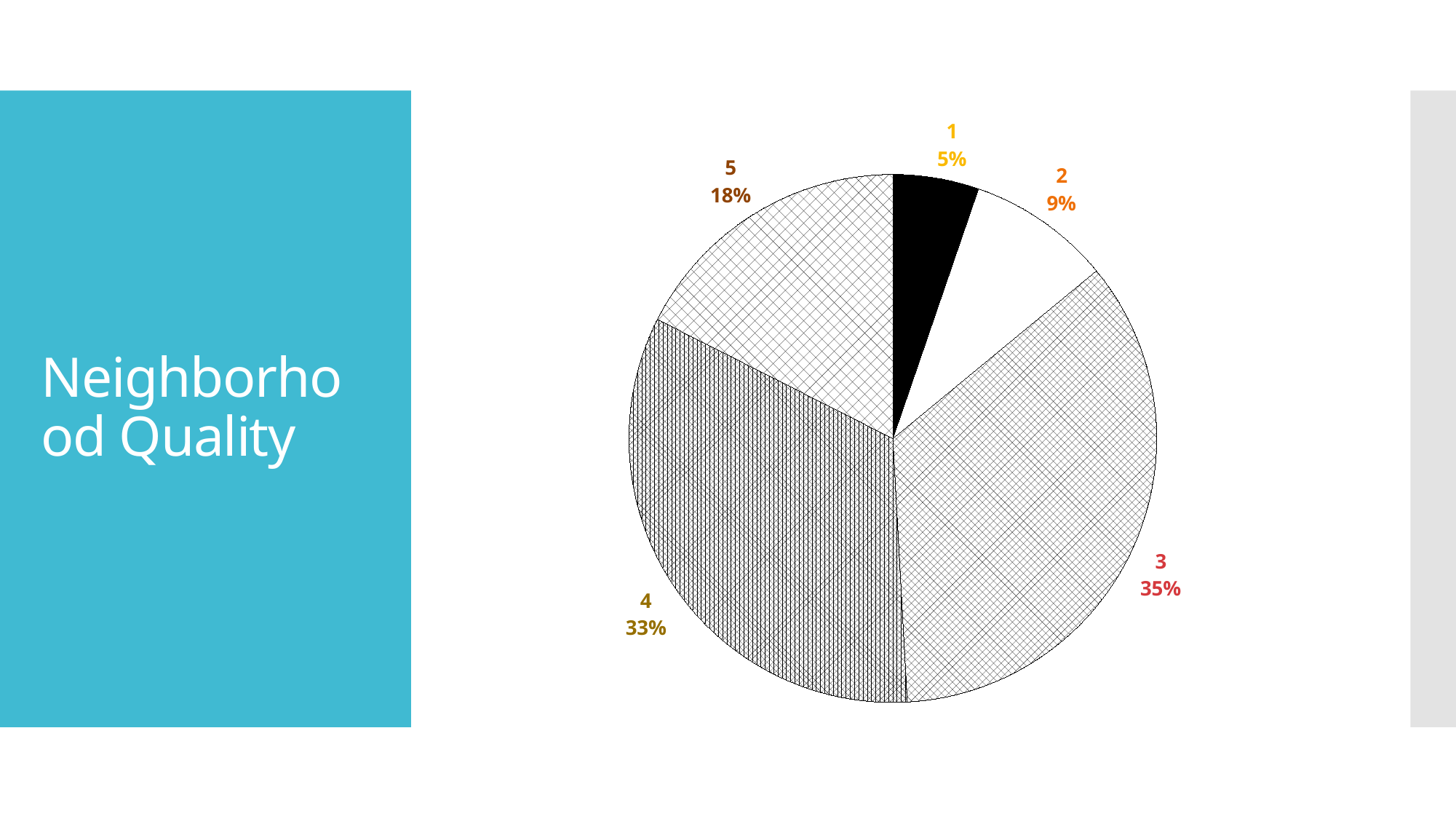
What share of the pie does category 5 represent? 18% What is the difference in percentage points between category 4 and category 5? 15 What is the title text shown on the slide next to the chart? Neighborhood Quality What share of the pie does category 3 represent? 35% Which category has the largest slice of the pie? 3 How many slices does the pie chart have? 5 Which is larger, the slice for category 4 or the slice for category 5? 4 What kind of chart is shown on the slide? pie chart What is the difference in percentage points between category 2 and category 1? 4 Which category has the smallest slice of the pie? 1 What is the combined share of categories 3 and 4? 68% What share of the pie does category 1 represent? 5%